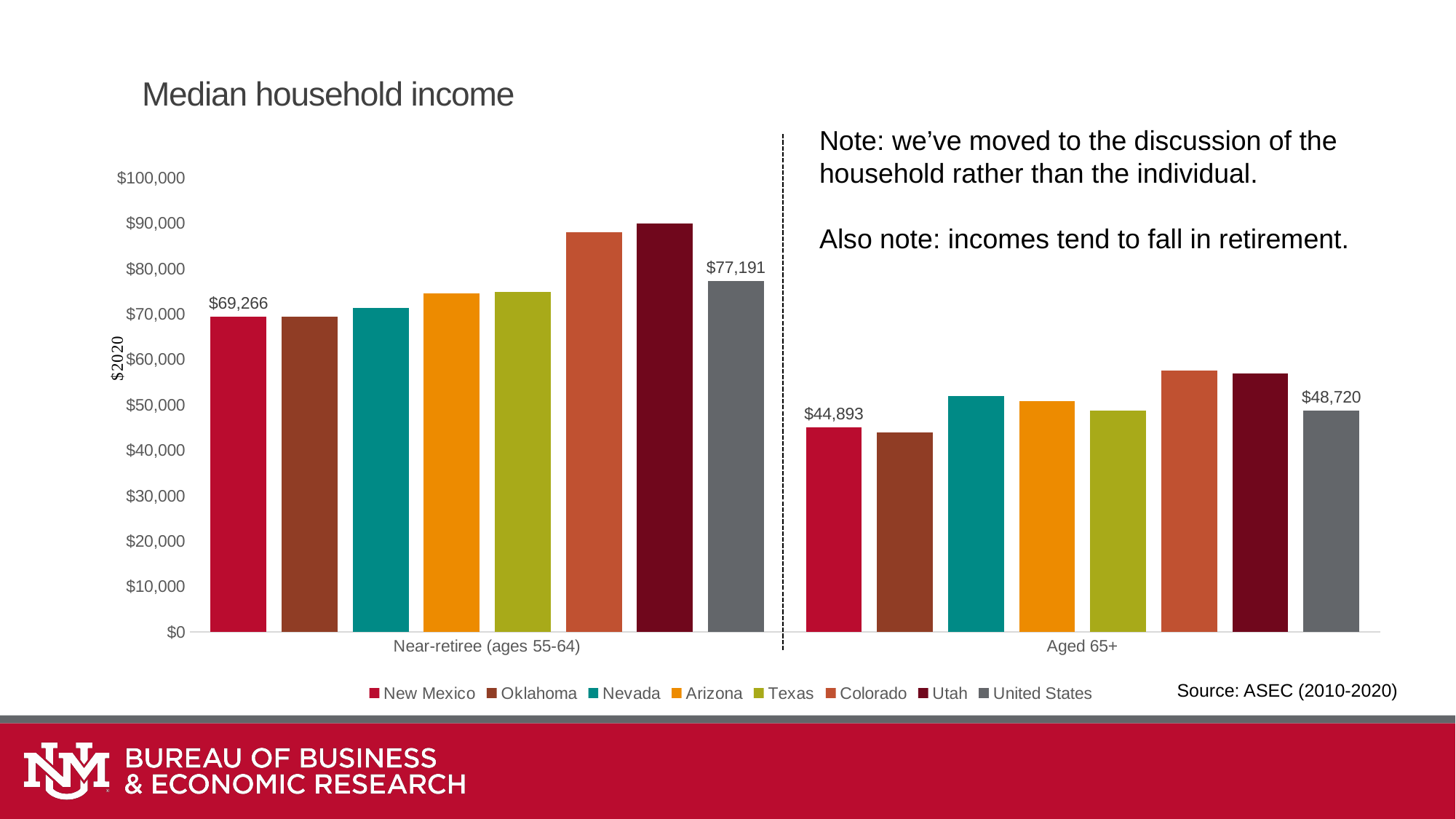
Is the median household income for Oklahoma in the Aged 65+ group greater or less than $50,000? less How much higher is the United States median household income than New Mexico's in the Aged 65+ group? $3,827 Which state has the highest median household income in the Near-retiree (ages 55-64) group? Utah How many series does the legend list? 8 What kind of chart is shown on the slide? Bar chart What is the median household income for the United States in the Near-retiree (ages 55-64) group? $77,191 Is the median household income for Colorado in the Near-retiree (ages 55-64) group greater or less than $80,000? greater What is the median household income for New Mexico in the Near-retiree (ages 55-64) group? $69,266 How much higher is the United States median household income than New Mexico's in the Near-retiree (ages 55-64) group? $7,925 What is the median household income for New Mexico in the Aged 65+ group? $44,893 What is the median household income for the United States in the Aged 65+ group? $48,720 Which is larger: New Mexico's median household income for Near-retiree (ages 55-64) or for Aged 65+? Near-retiree (ages 55-64)